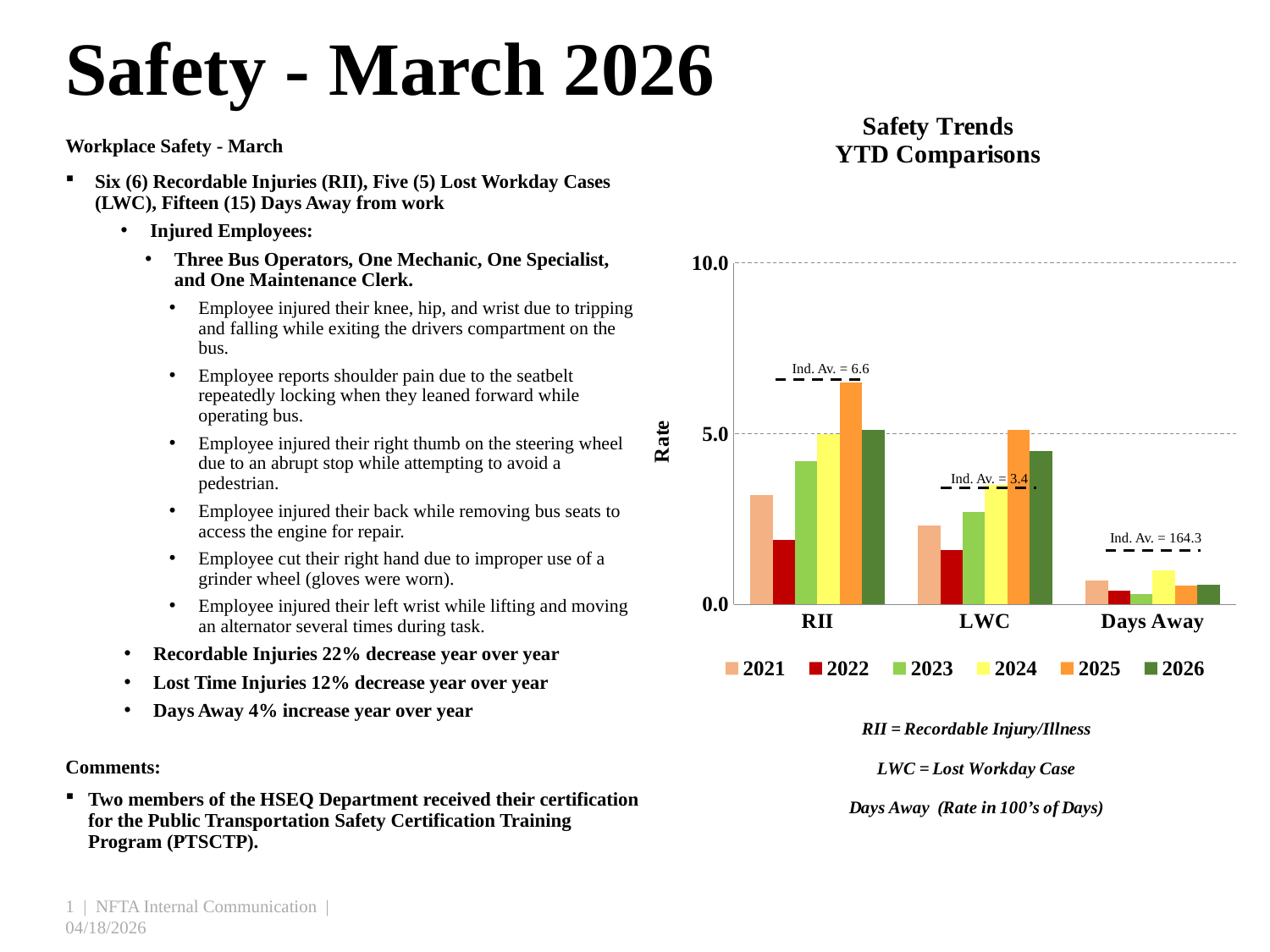
What is the title of the chart? Safety Trends YTD Comparisons What industry average is annotated for the Days Away category? 164.3 What industry average is annotated for the LWC category? 3.4 Which year has the lowest bar in the RII category? 2022 How many series does the chart legend list? 6 What kind of chart is shown on the slide? Bar chart What is the label of the vertical axis of the chart? Rate What industry average is annotated for the RII category? 6.6 In the LWC category, which is larger, the value for 2023 or the value for 2022? 2023 Which year has the highest bar in the RII category? 2025 How many categories are shown on the x axis of the chart? 3 Is the value for 2025 in the RII category greater or less than 5.0? greater